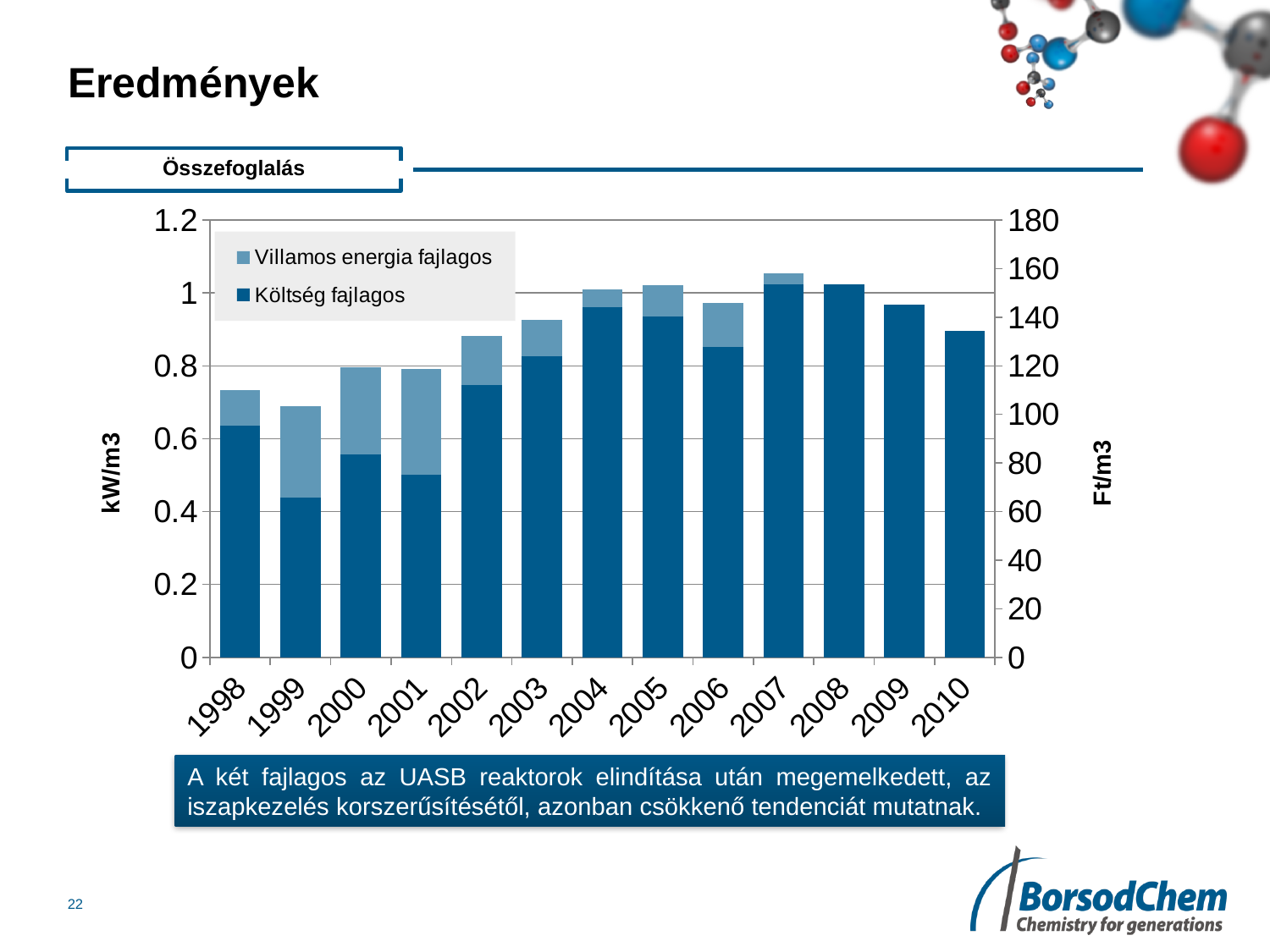
Is the dark blue (Költség fajlagos) bar larger in 2001 or in 2002? 2002 Which year has the lowest dark blue (Költség fajlagos) bar? 1999 What are the two series named in the chart legend? Villamos energia fajlagos and Költség fajlagos Is the dark blue (Költség fajlagos) bar larger in 1998 or in 1999? 1998 How many years are shown on the x axis of the chart? 13 On the left (kW/m3) axis, is the top of the 1999 bar greater or less than 0.8? less What is the label of the left vertical axis of the chart? kW/m3 What kind of chart is shown on the slide? bar chart Do the bar heights generally rise or fall from 1998 to 2007? rise Which year has the tallest bar overall in the chart? 2007 On the left (kW/m3) axis, is the top of the 2007 bar greater or less than 1? greater How many series does the chart legend list? 2